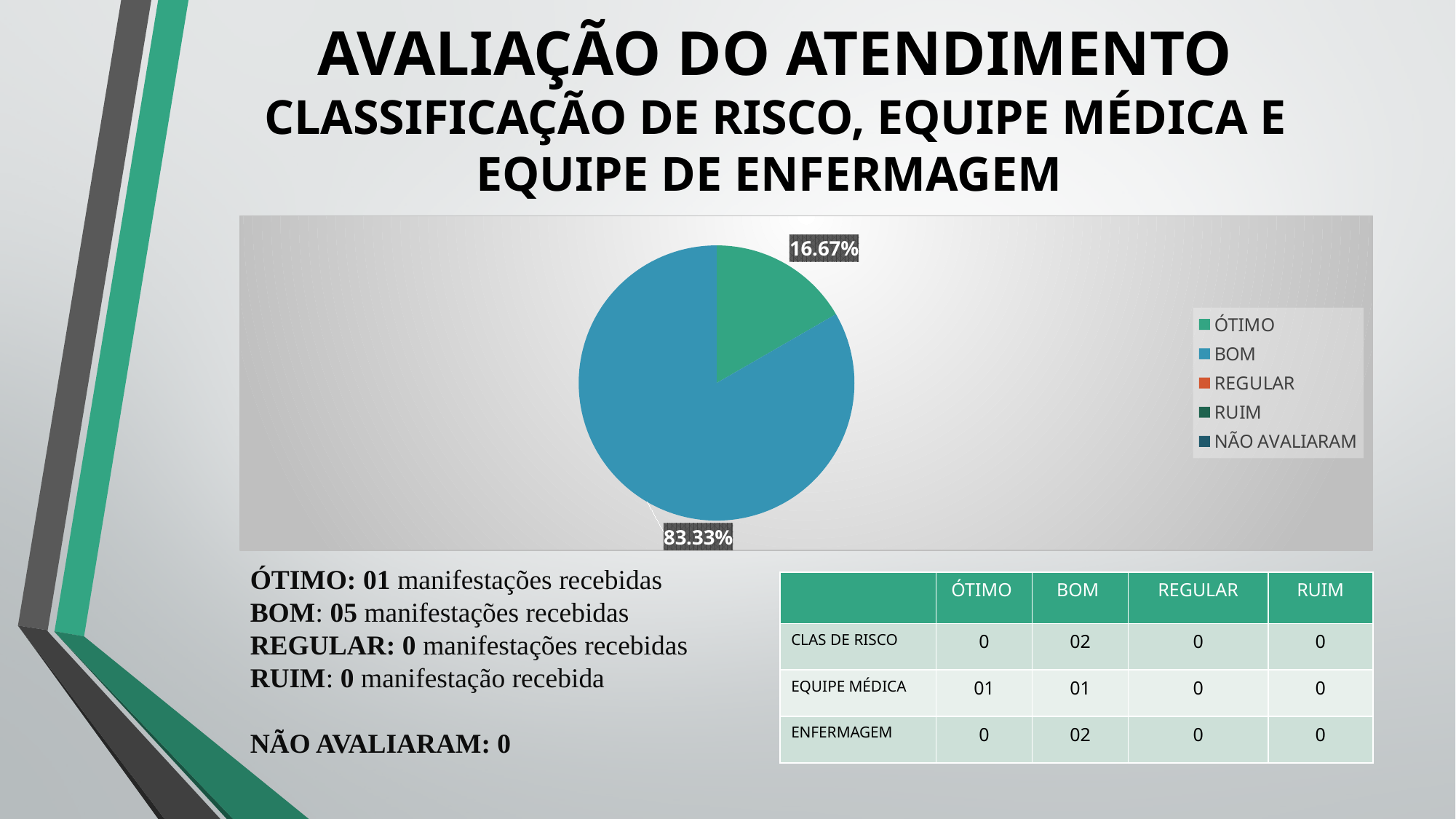
What percentage does the BOM slice of the pie chart represent? 83.33% How many entries does the legend of the pie chart list? 5 How many slices are visibly plotted in the pie chart? 2 What is the difference in percentage points between the BOM slice and the ÓTIMO slice? 66.66% Which category has the largest slice in the pie chart? BOM What colour is the BOM slice in the pie chart? blue Which of the two labelled slices is larger, ÓTIMO or BOM? BOM Is the BOM slice of the pie chart greater or less than 50%? greater Which legend entry is listed last in the pie chart's legend? NÃO AVALIARAM What percentage does the ÓTIMO slice of the pie chart represent? 16.67% What kind of chart is shown on the slide? pie chart Is the ÓTIMO slice of the pie chart greater or less than 25%? less